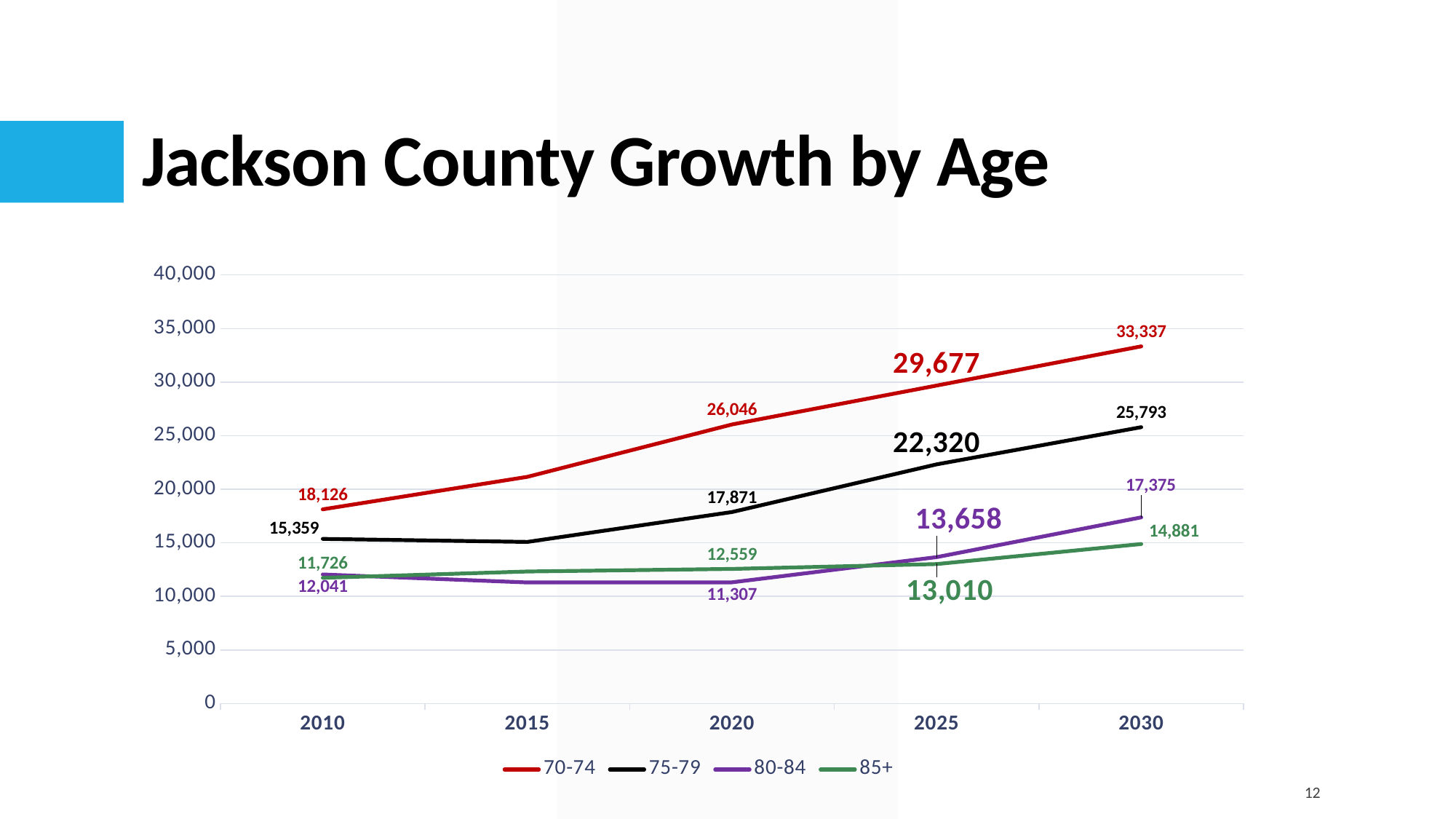
What is the value for the 80-84 series in 2020? 11,307 What is the value for the 75-79 series in 2025? 22,320 What is the difference between the 70-74 value and the 75-79 value in 2030? 7,544 Which series has the lowest value in 2020? 80-84 Which series has the highest value in 2030? 70-74 What is the value for the 85+ series in 2010? 11,726 Which is larger in 2025, the 80-84 value or the 85+ value? 80-84 What type of chart is shown on the slide? line chart How many years are shown on the x axis? 5 Is the value for the 75-79 series in 2015 greater or less than 20,000? less What is the value for the 70-74 series in 2030? 33,337 How many series does the legend list? 4